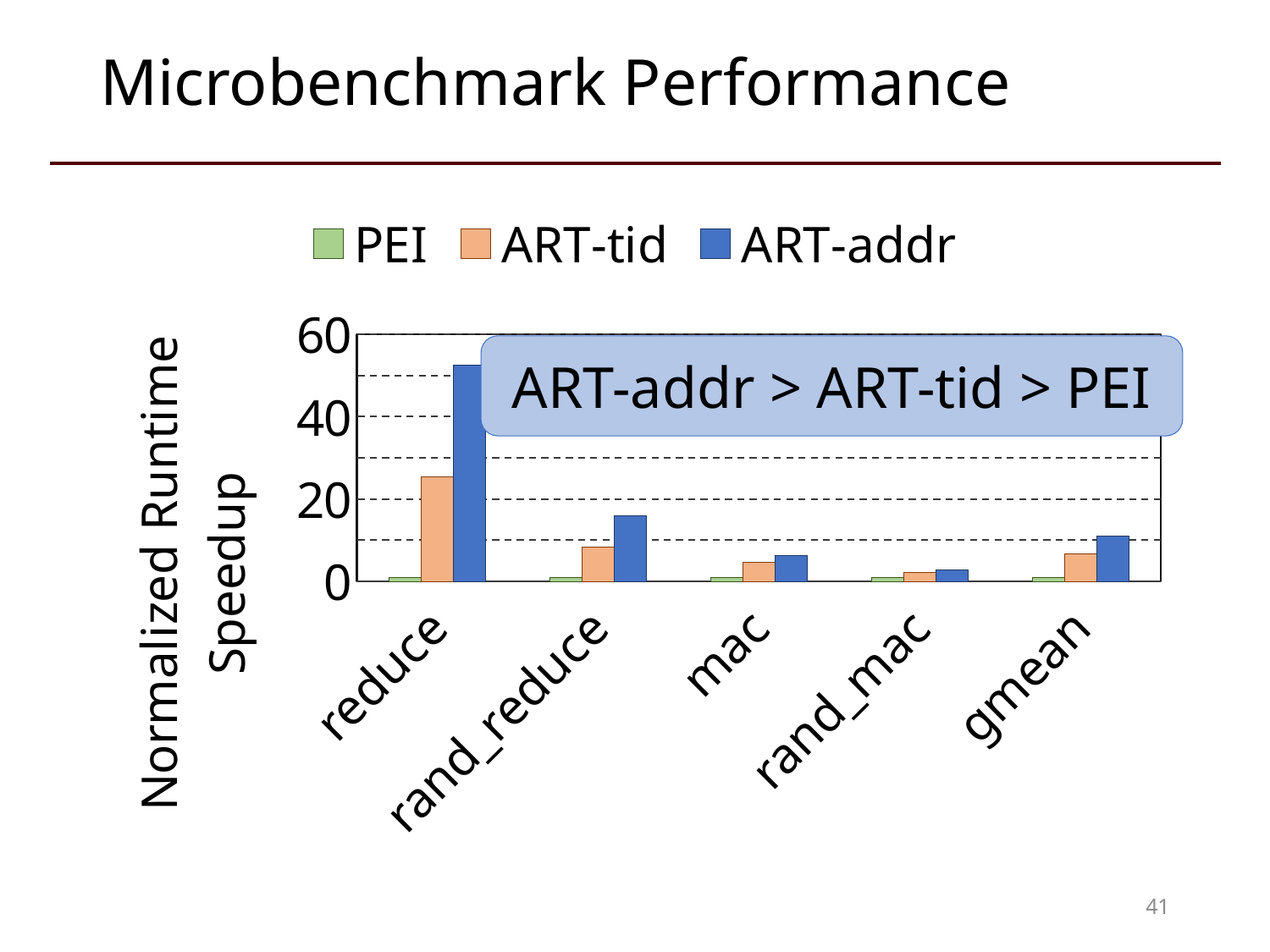
Is the ART-tid value for reduce greater or less than 20? greater How many series does the legend list? 3 Which benchmark has the highest ART-addr bar? reduce Which series is shown in blue in the legend? ART-addr How many benchmark categories are shown on the x axis? 5 Is the ART-addr value for reduce greater or less than 40? greater What kind of chart is shown on the slide? bar chart What is the label on the y axis? Normalized Runtime Speedup Is the ART-addr value for rand_reduce greater or less than 20? less Which benchmark has the lowest ART-addr bar? rand_mac For rand_reduce, which is larger: the ART-tid bar or the ART-addr bar? ART-addr